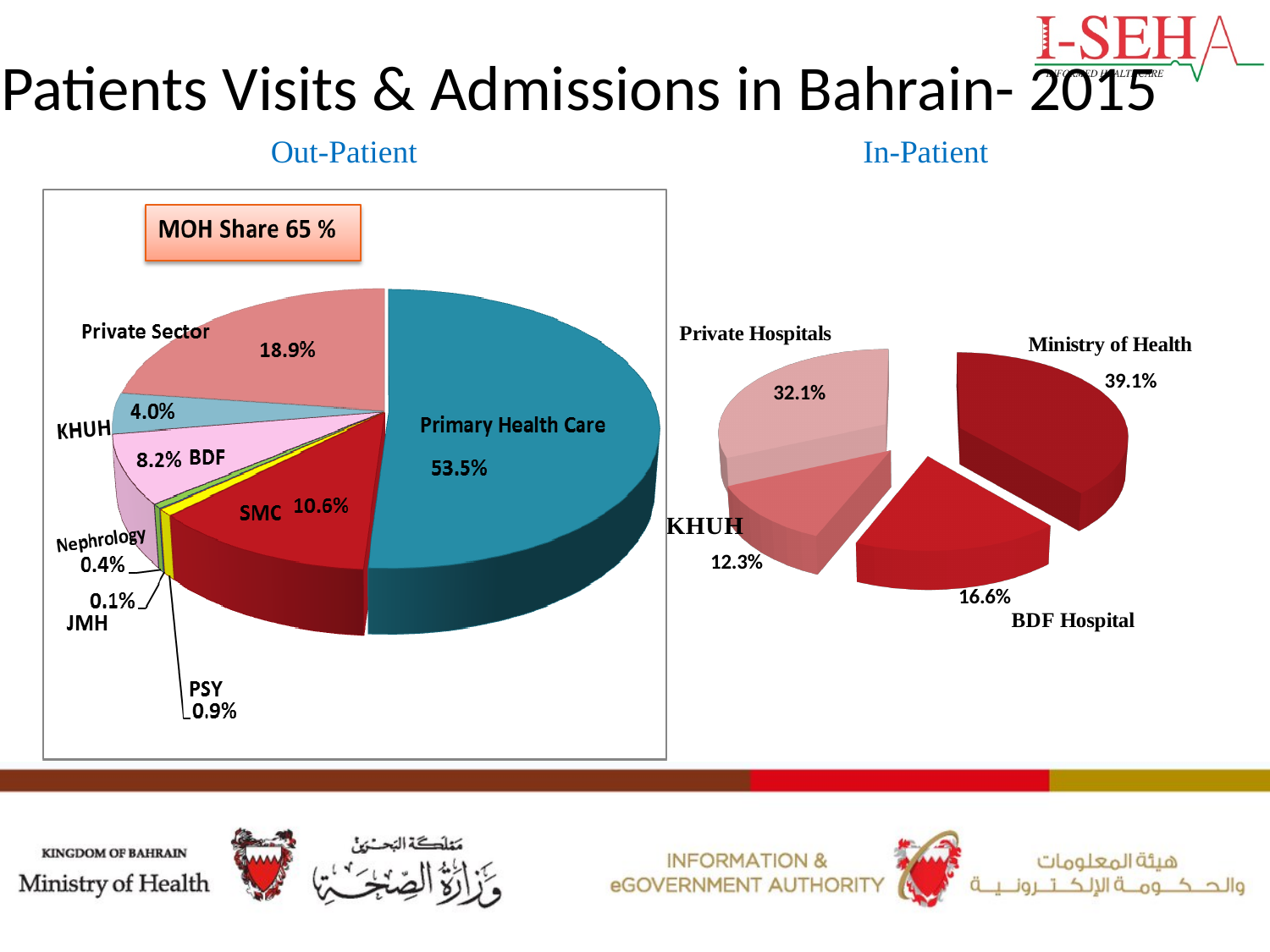
In the Out-Patient chart, how many slices does the pie have? 8 In the Out-Patient chart, what is the value for SMC? 10.6% In the In-Patient chart, what is the value for the Ministry of Health? 39.1% In the Out-Patient chart, what share does Primary Health Care have? 53.5% In the Out-Patient chart, which category has the smallest share? JMH In the Out-Patient chart, what is the value for the Private Sector? 18.9% In the Out-Patient chart, what is the difference between the BDF and KHUH shares? 4.2% In the In-Patient chart, which is larger, Private Hospitals or Ministry of Health? Ministry of Health What kind of chart is the In-Patient chart? Pie chart In the In-Patient chart, what is the value for BDF Hospital? 16.6% In the In-Patient chart, which category has the smallest share? KHUH In the Out-Patient chart, which category has the largest share? Primary Health Care